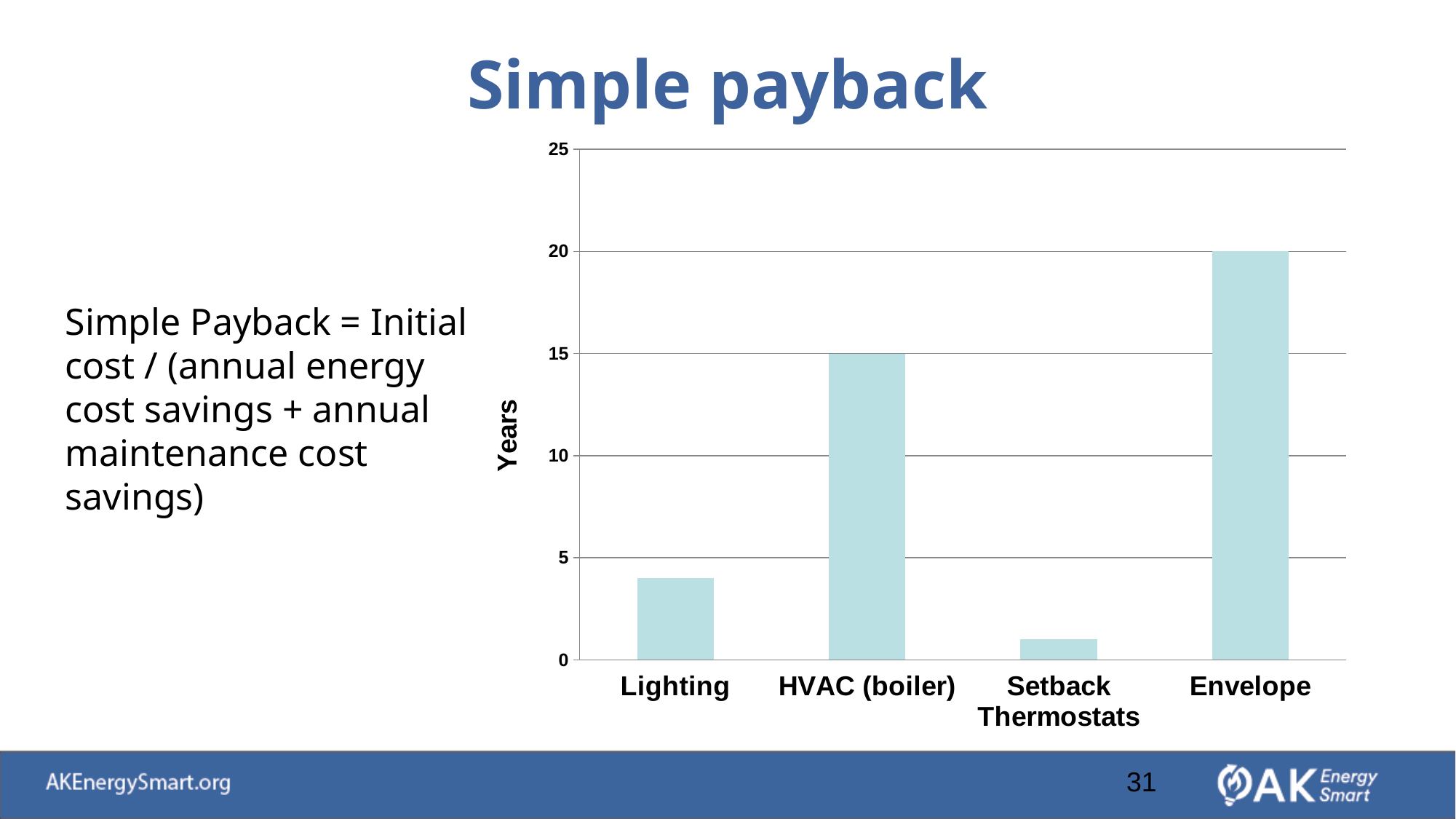
Is the value for Lighting greater or less than 5? less What is the title of the slide containing the chart? Simple payback How many categories are shown on the x axis of the chart? 4 What is the difference in years between the Envelope and HVAC (boiler) payback values? 5 Which category has the lowest simple payback? Setback Thermostats What is the simple payback in years for HVAC (boiler)? 15 Which category has the highest simple payback? Envelope What is the label on the y axis of the chart? Years Which has a longer simple payback, Lighting or HVAC (boiler)? HVAC (boiler) Is the value for Setback Thermostats greater or less than 5? less What type of chart is shown on the slide? bar chart What is the simple payback in years for Envelope? 20